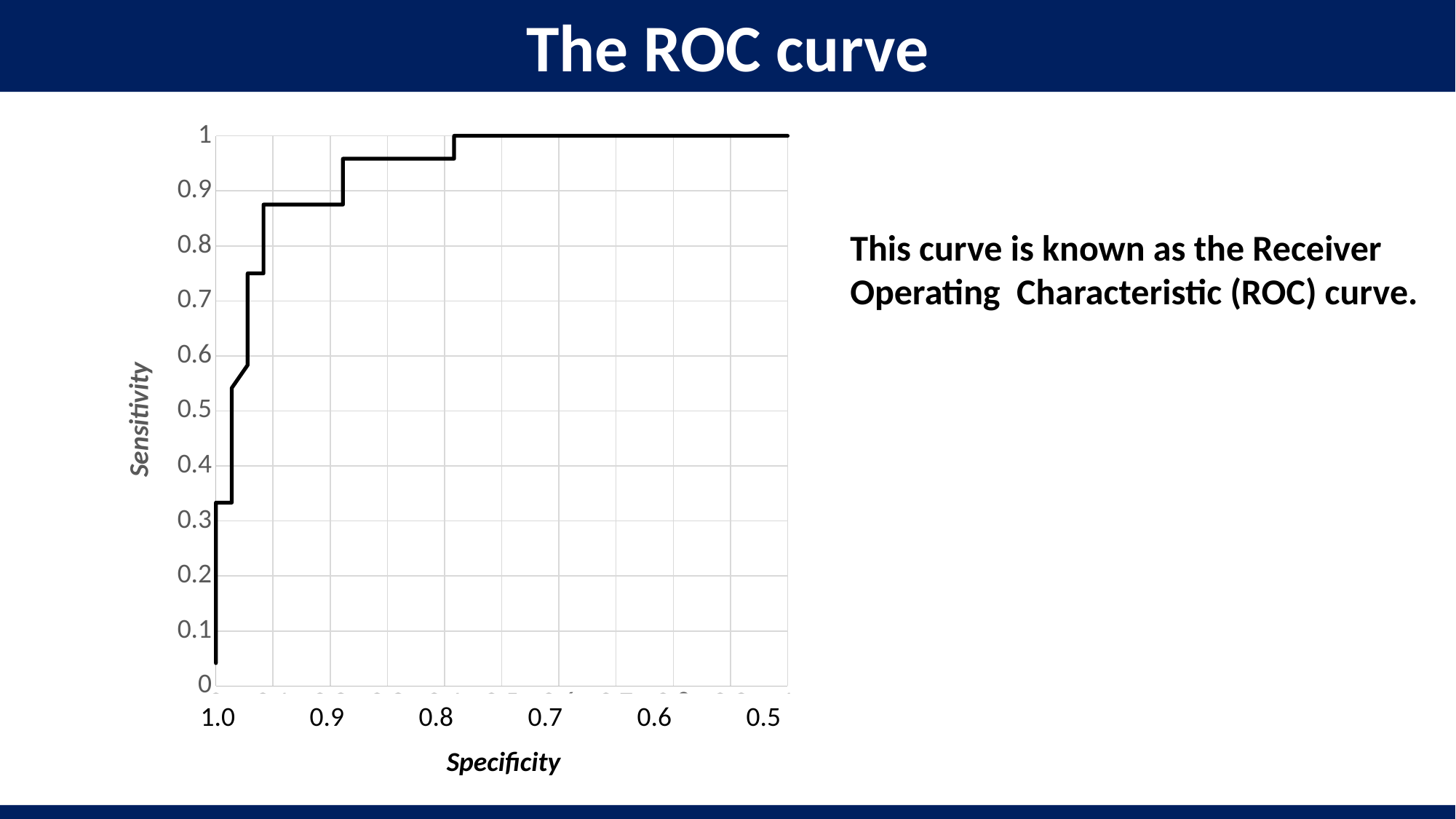
What kind of chart is shown on the slide? line chart What is the lowest value shown on the y axis of the chart? 0 Is the sensitivity at a specificity of 0.8 greater or less than 0.9? greater Moving from left to right along the x axis, does the sensitivity rise or fall? rise Is the sensitivity at a specificity of 0.6 greater or less than 0.5? greater Is the sensitivity at a specificity of 0.7 greater or less than 0.9? greater What is the highest sensitivity value the curve reaches? 1 What is the label of the y axis of the chart? Sensitivity What is the label of the x axis of the chart? Specificity